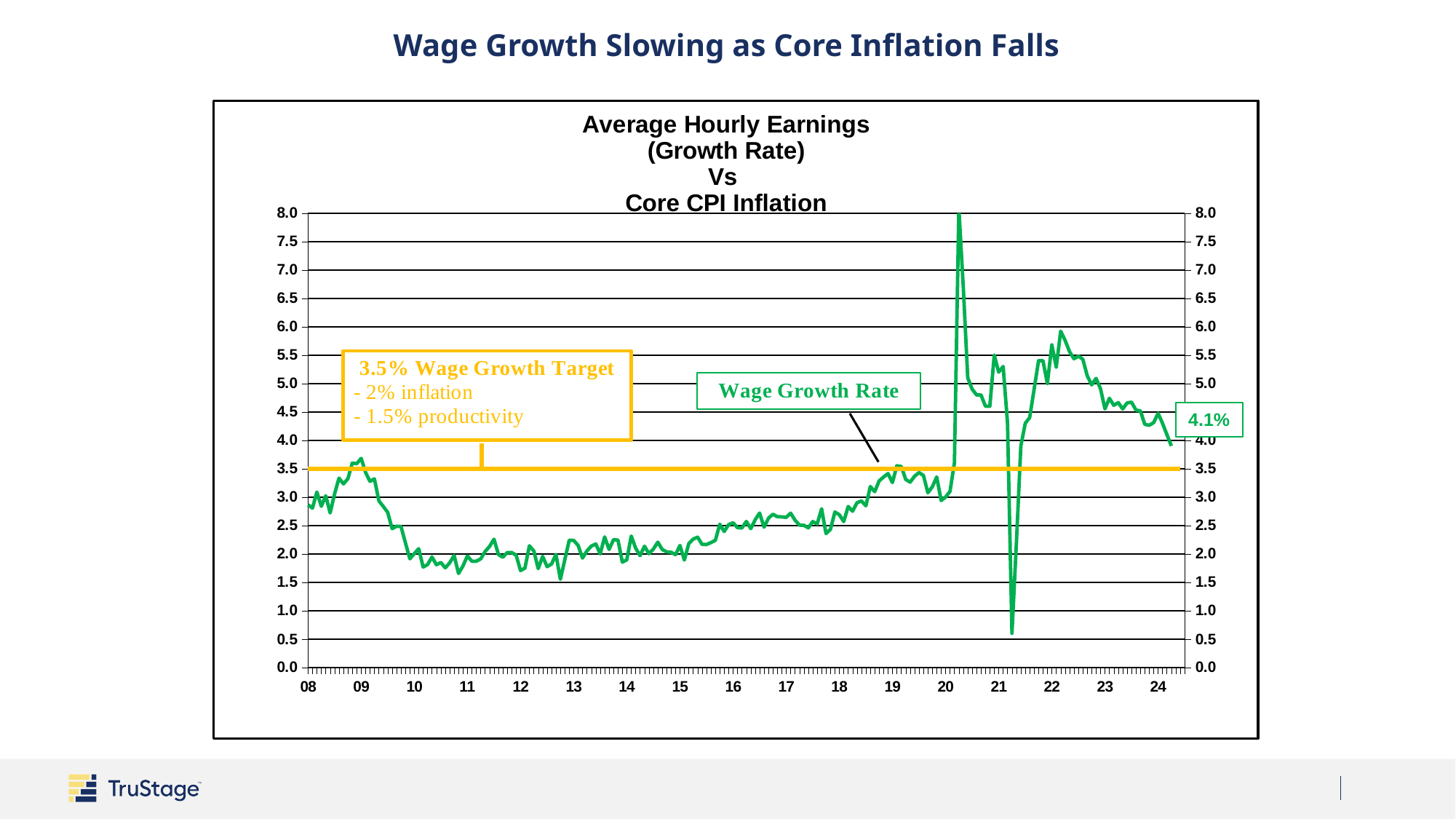
In which year does the Wage Growth Rate reach its lowest point on the chart? 2021 Is the peak Wage Growth Rate in 2020 greater or less than 7.0? greater What is the title of the chart? Average Hourly Earnings (Growth Rate) Vs Core CPI Inflation Does the Wage Growth Rate rise or fall from 2022 to 2024? Fall What kind of chart is shown on the slide? Line chart What two components make up the 3.5% Wage Growth Target according to the annotation box? 2% inflation and 1.5% productivity Is the lowest Wage Growth Rate value in 2021 greater or less than 1.0? less At what level is the Wage Growth Target line drawn? 3.5% What is the most recent value of the Wage Growth Rate labelled on the chart? 4.1% In which year does the Wage Growth Rate reach its highest point on the chart? 2020 Is the Wage Growth Rate during 2011 greater or less than 2.5? less Is the latest Wage Growth Rate value (4.1%) greater or less than the 3.5% Wage Growth Target? greater